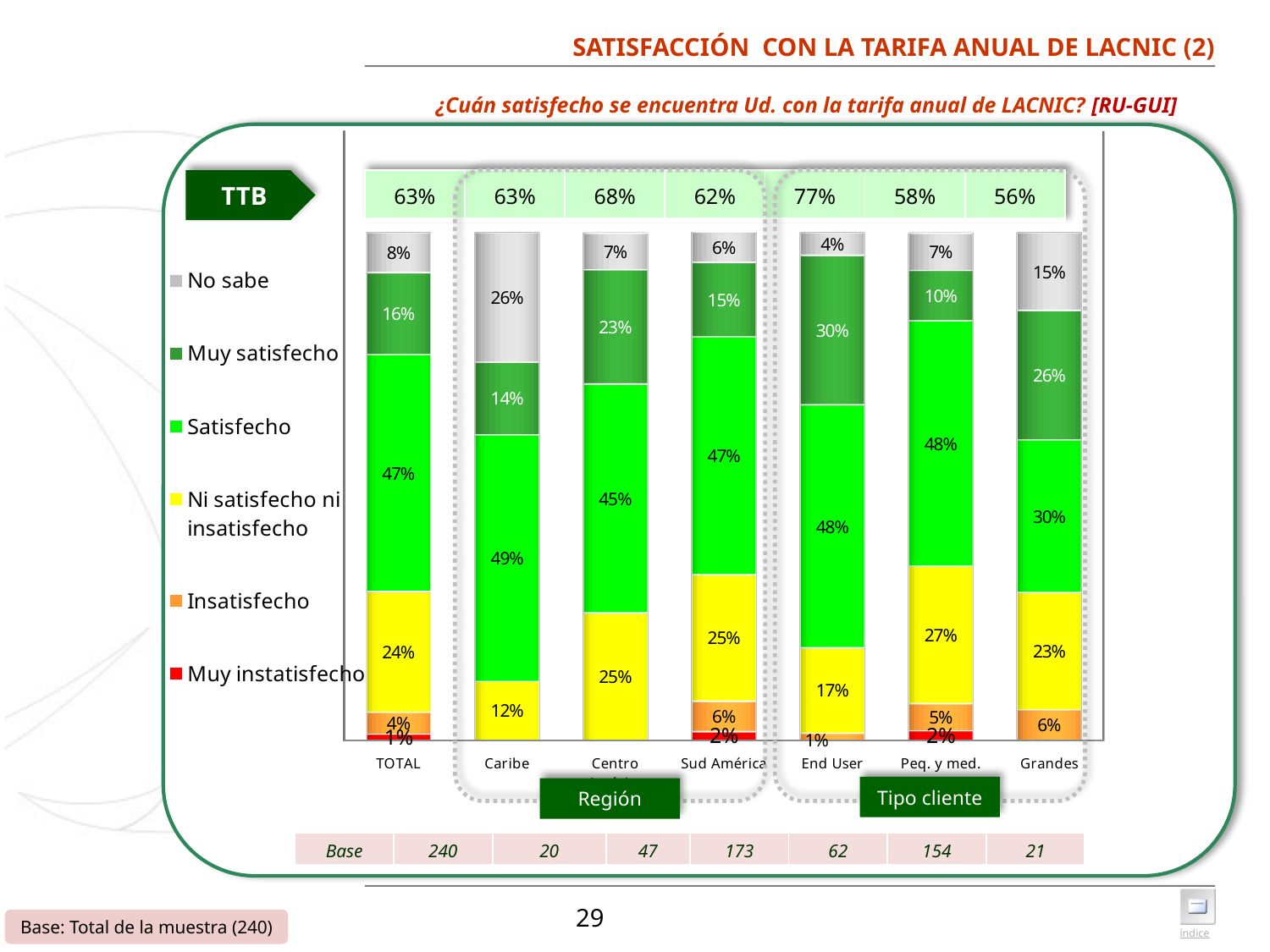
What is the No sabe value for Caribe? 26% What is the Muy satisfecho value for End User? 30% What kind of chart is shown on the slide? Stacked bar chart What is the Satisfecho value for the TOTAL bar? 47% What is the Ni satisfecho ni insatisfecho value for Peq. y med.? 27% How many series does the legend list? 6 How many categories (bars) are plotted along the x axis? 7 Which category has the lowest Satisfecho value? Grandes Which is larger, the No sabe value for Grandes or the No sabe value for Sud América? Grandes Which category has the highest Muy satisfecho value? End User What is the difference between the Satisfecho values for Caribe and Grandes? 19% What TTB value is shown above the End User bar? 77%